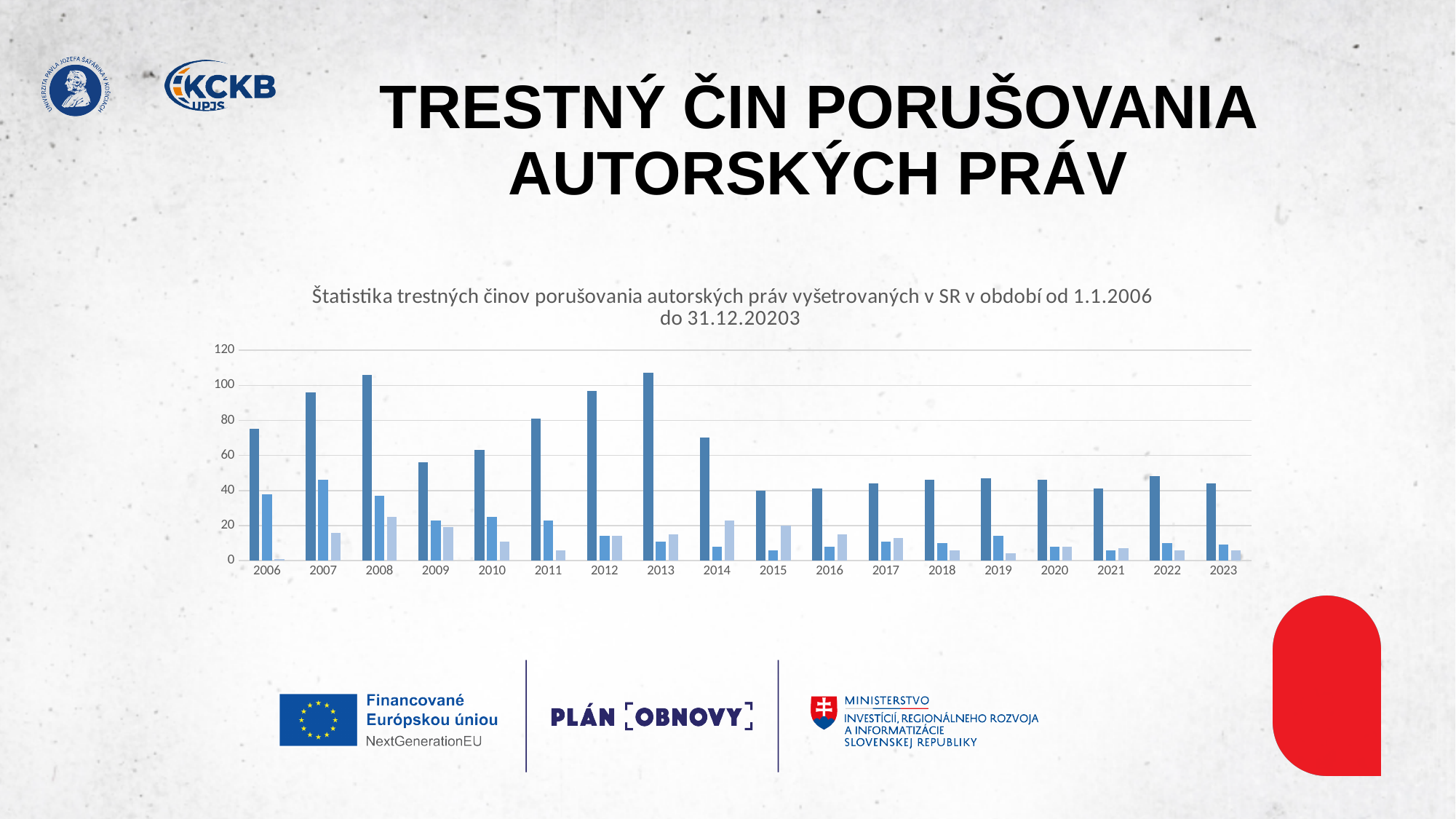
What kind of chart is shown on the slide? bar chart Do the dark blue bars rise or fall from 2013 to 2015? fall Is the value of the dark blue bar for 2023 greater or less than 60? less What is the last year shown on the x axis of the chart? 2023 Is the value of the dark blue bar for 2015 greater or less than 60? less Which year has the larger dark blue bar, 2012 or 2014? 2012 Which year has the larger dark blue bar, 2007 or 2009? 2007 Is the value of the dark blue bar for 2008 greater or less than 100? greater What is the first year shown on the x axis of the chart? 2006 How many years are shown along the x axis of the chart? 18